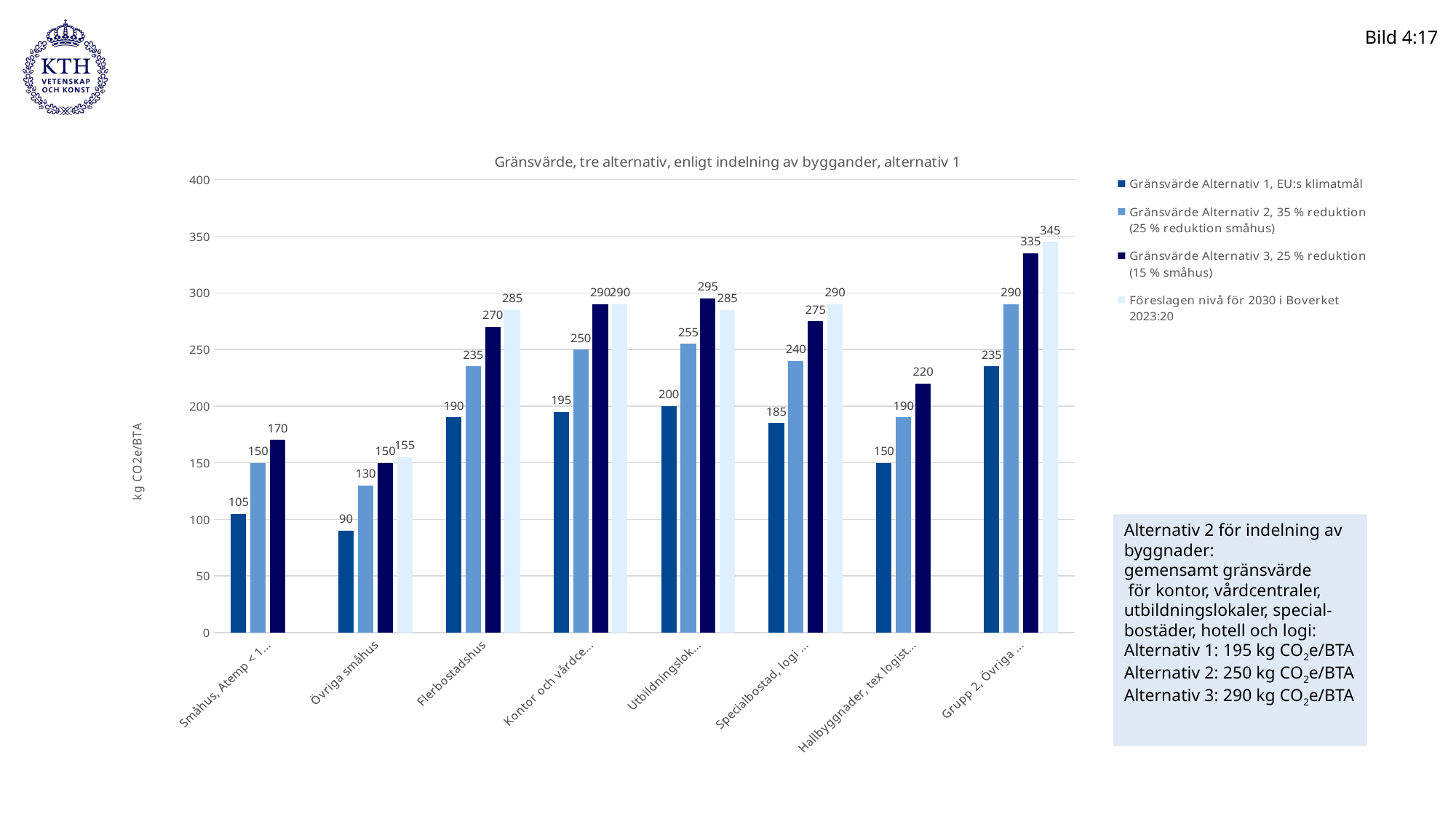
Which category has the lowest value for Gränsvärde Alternativ 1, EU:s klimatmål? Övriga småhus What is the value of Gränsvärde Alternativ 1, EU:s klimatmål for Flerbostadshus? 190 Is the value of Gränsvärde Alternativ 2 for Flerbostadshus greater or less than 200? greater How many building categories are shown on the x axis? 8 Which is larger: Gränsvärde Alternativ 2 for Övriga småhus or Gränsvärde Alternativ 1 for Flerbostadshus? Gränsvärde Alternativ 1 for Flerbostadshus What is the label of the y axis? kg CO2e/BTA How many series does the legend list? 4 What is the value of Gränsvärde Alternativ 3 for Övriga småhus? 150 What is the value of Gränsvärde Alternativ 2 for Övriga småhus? 130 What is the Föreslagen nivå för 2030 i Boverket 2023:20 value for Flerbostadshus? 285 What kind of chart is shown on the slide? bar chart For Flerbostadshus, what is the difference between Gränsvärde Alternativ 3 and Gränsvärde Alternativ 1? 80